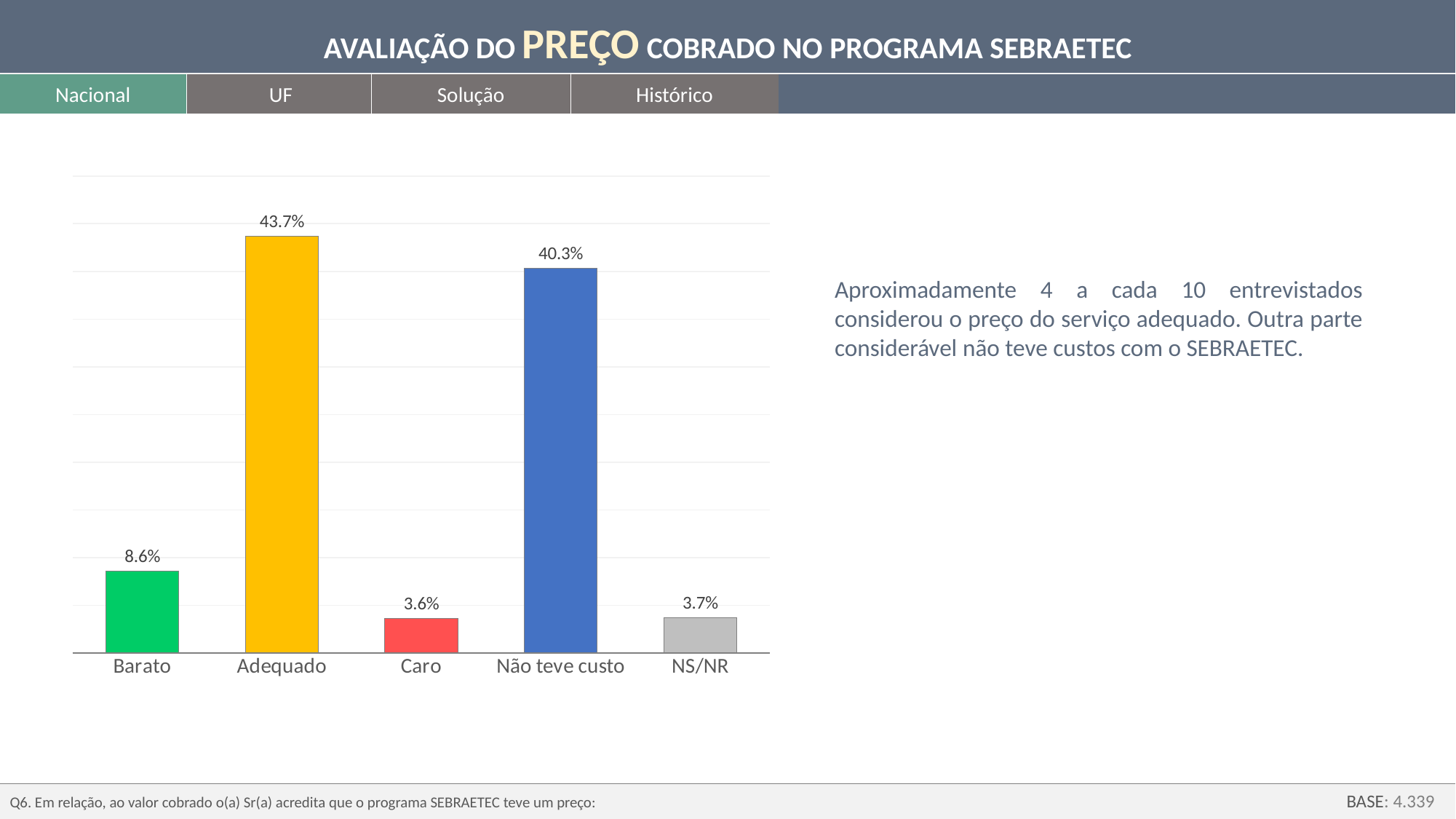
Which is larger, the value for Barato or the value for NS/NR? Barato Which category has the highest value? Adequado What is the difference between the values for Adequado and Não teve custo? 3.4% What is the difference between the values for Barato and Caro? 5.0% What kind of chart is shown on the slide? Bar chart What is the value for Não teve custo? 40.3% What is the value for Adequado? 43.7% What is the value for NS/NR? 3.7% What is the value for Barato? 8.6% What colour is the bar for Não teve custo? Blue How many categories are shown on the x axis? 5 What is the value for Caro? 3.6%